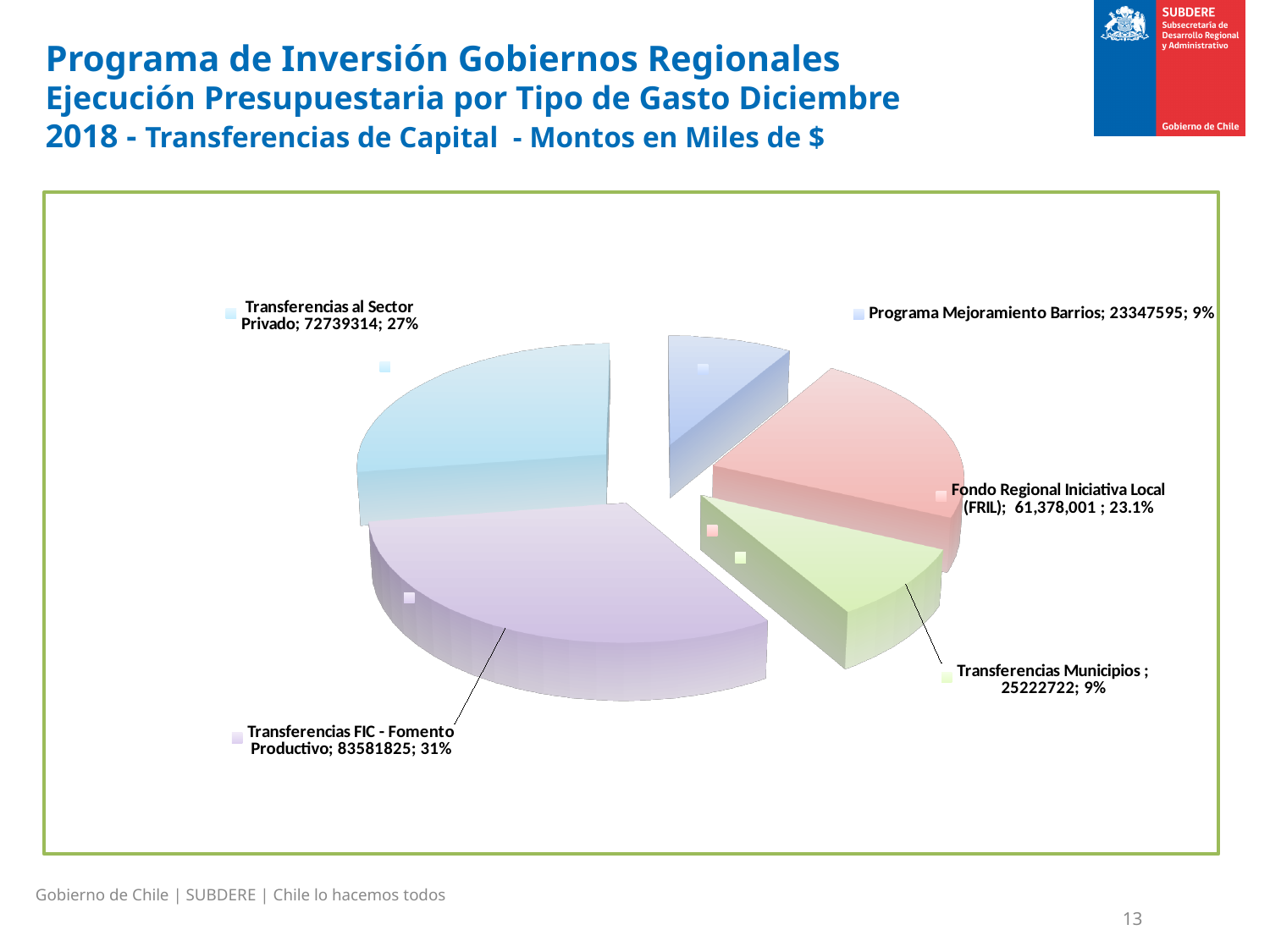
What is the value shown for Programa Mejoramiento Barrios? 23347595 What is the difference between the values for Transferencias Municipios and Programa Mejoramiento Barrios? 1875127 What is the value shown for Transferencias FIC - Fomento Productivo? 83581825 Which category has the smallest slice of the pie? Programa Mejoramiento Barrios What is the difference between the values for Transferencias FIC - Fomento Productivo and Transferencias al Sector Privado? 10842511 Which is larger, the value for Transferencias al Sector Privado or the value for Fondo Regional Iniciativa Local (FRIL)? Transferencias al Sector Privado How many categories are shown in the pie chart? 5 Which category has the largest slice of the pie? Transferencias FIC - Fomento Productivo What kind of chart is shown on the slide? Pie chart What is the value shown for Fondo Regional Iniciativa Local (FRIL)? 61,378,001 What percentage share of the pie does Transferencias al Sector Privado represent? 27% What percentage share of the pie does Fondo Regional Iniciativa Local (FRIL) represent? 23.1%